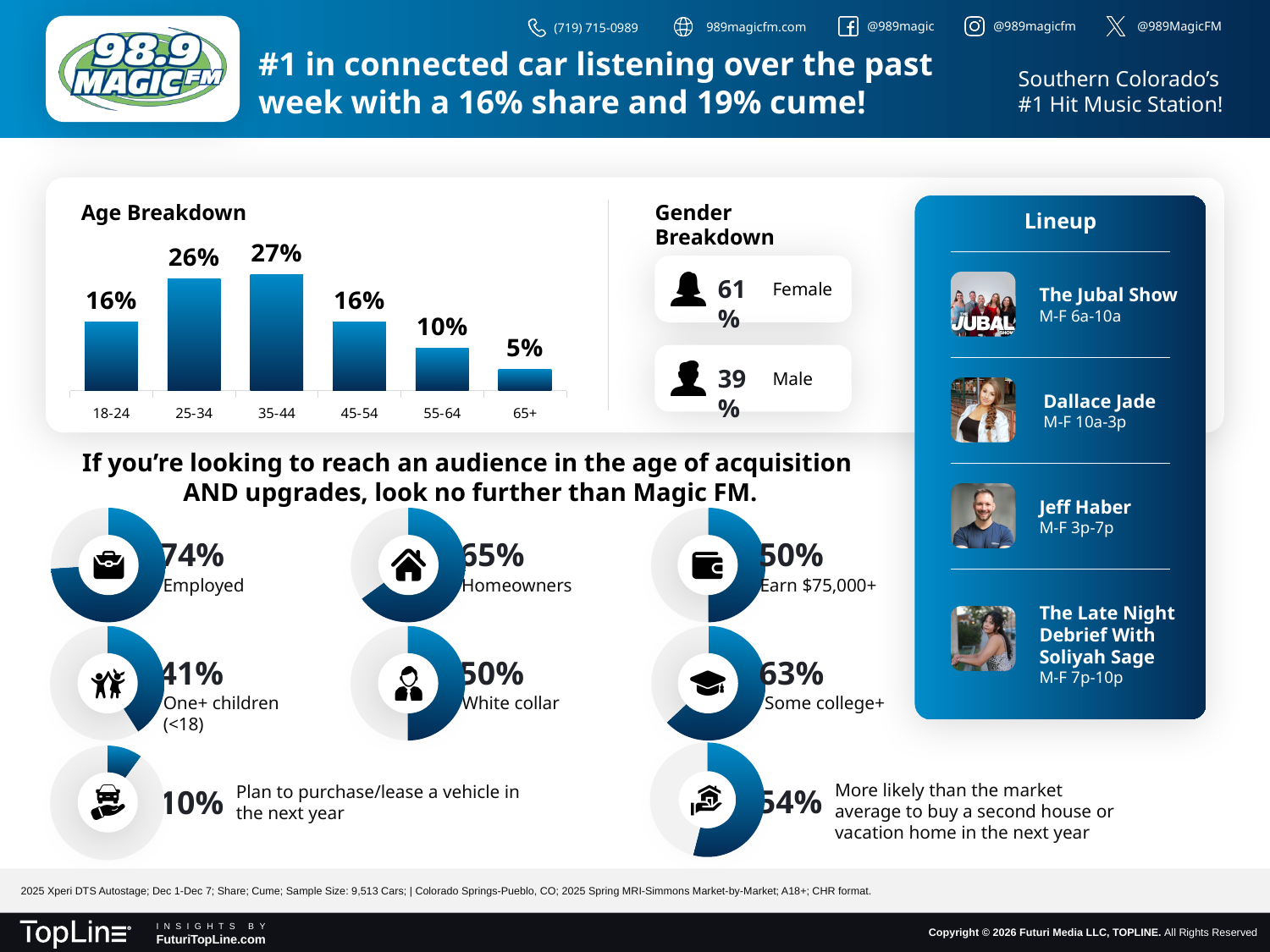
What kind of chart is the Age Breakdown chart? Bar chart In the Gender Breakdown, what percentage of the audience is Female? 61% In the Age Breakdown chart, which age group has the lowest value? 65+ In the Age Breakdown chart, which age group has the highest value? 35-44 In the Age Breakdown chart, what is the value for the 25-34 age group? 26% In the Age Breakdown chart, do the values rise or fall from 35-44 to 65+? Fall In the donut charts at the bottom of the slide, what percentage of the audience is Homeowners? 65% How many age groups are shown in the Age Breakdown chart? 6 In the donut charts at the bottom of the slide, what percentage plan to purchase/lease a vehicle in the next year? 10% In the Age Breakdown chart, what is the difference between the 35-44 and 55-64 values? 17% In the Age Breakdown chart, which is larger, the value for 18-24 or the value for 25-34? 25-34 In the Age Breakdown chart, what is the value for the 65+ age group? 5%